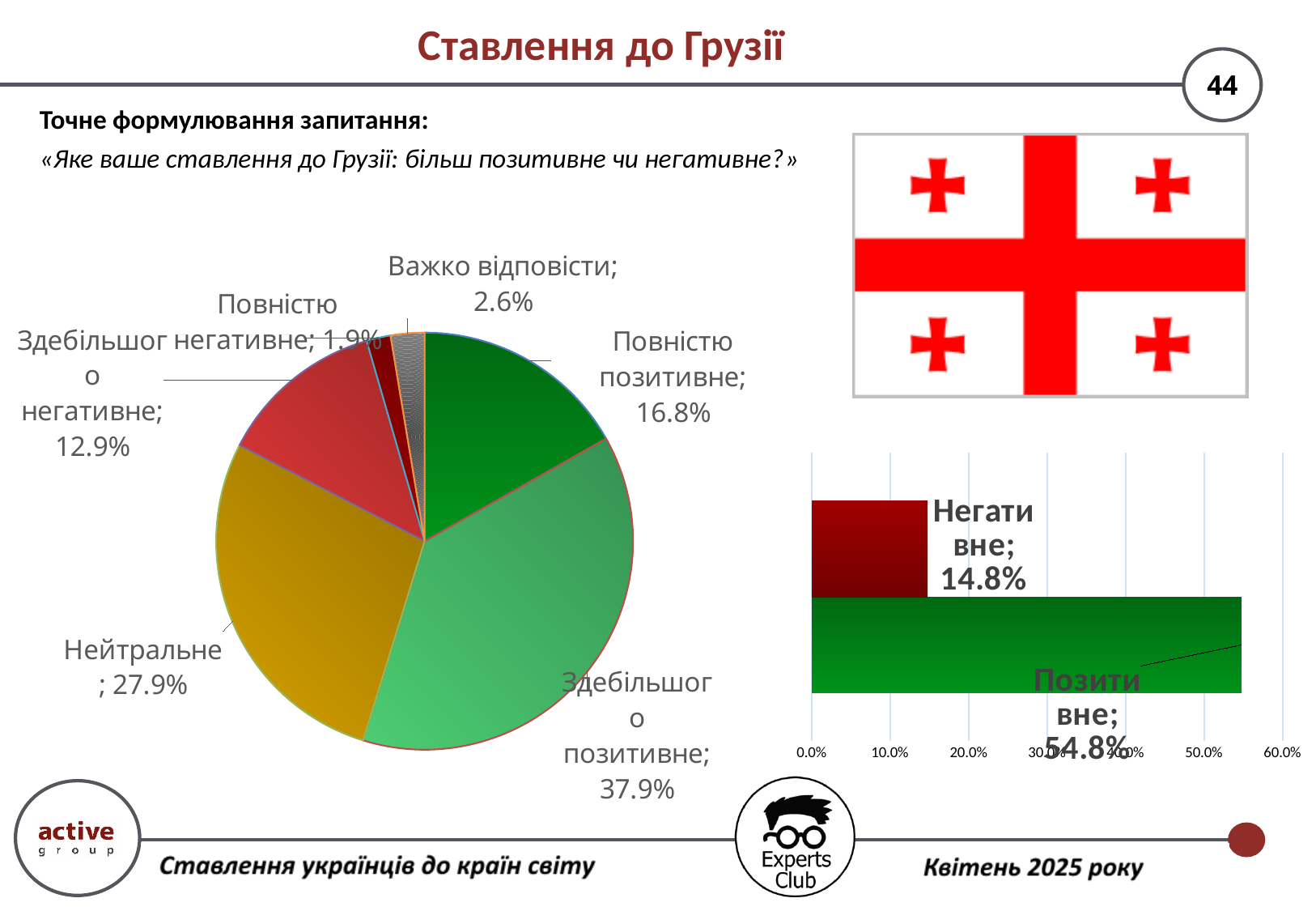
In the pie chart, which category has the largest share? Здебільшого позитивне In the pie chart, which category has the smallest share? Повністю негативне In the pie chart, what is the value for «Важко відповісти»? 2.6% In the pie chart, what is the value for «Здебільшого позитивне»? 37.9% In the pie chart, what is the value for «Нейтральне»? 27.9% In the pie chart, which is larger: «Нейтральне» or «Повністю позитивне»? Нейтральне In the bar chart on the right, what is the difference between «Позитивне» and «Негативне»? 40.0% What kind of chart is the chart on the left of the slide? pie chart In the pie chart, what is the difference between «Повністю позитивне» and «Здебільшого негативне»? 3.9% In the bar chart on the right, what is the value for «Позитивне»? 54.8% How many slices does the pie chart have? 6 What kind of chart is the chart on the right of the slide? bar chart